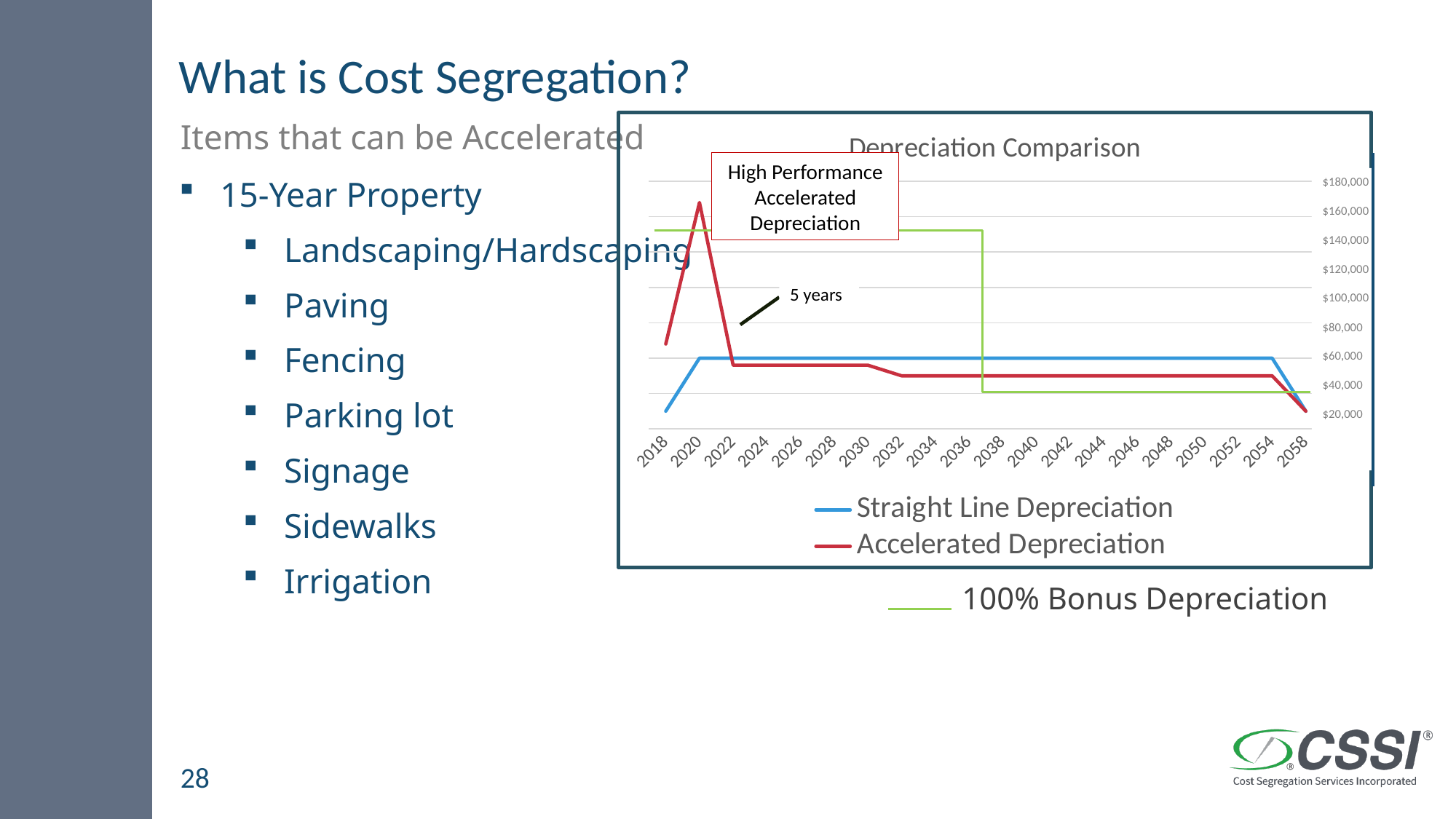
In the Depreciation Comparison chart, is the Accelerated Depreciation value for 2020 greater or less than $140,000? greater In the Depreciation Comparison chart, in which year does Accelerated Depreciation reach its highest value? 2020 What is the title of the chart on the slide? Depreciation Comparison How many series does the legend inside the Depreciation Comparison chart list? 2 What kind of chart is the Depreciation Comparison chart? line chart In the Depreciation Comparison chart, which is larger in 2020: Straight Line Depreciation or Accelerated Depreciation? Accelerated Depreciation In the Depreciation Comparison chart, is the 100% Bonus Depreciation value for 2046 greater or less than $60,000? less In the Depreciation Comparison chart, is the Straight Line Depreciation value for 2018 greater or less than $40,000? less In the Depreciation Comparison chart, which series is drawn in red? Accelerated Depreciation In the Depreciation Comparison chart, does the Accelerated Depreciation line rise or fall between 2020 and 2022? fall